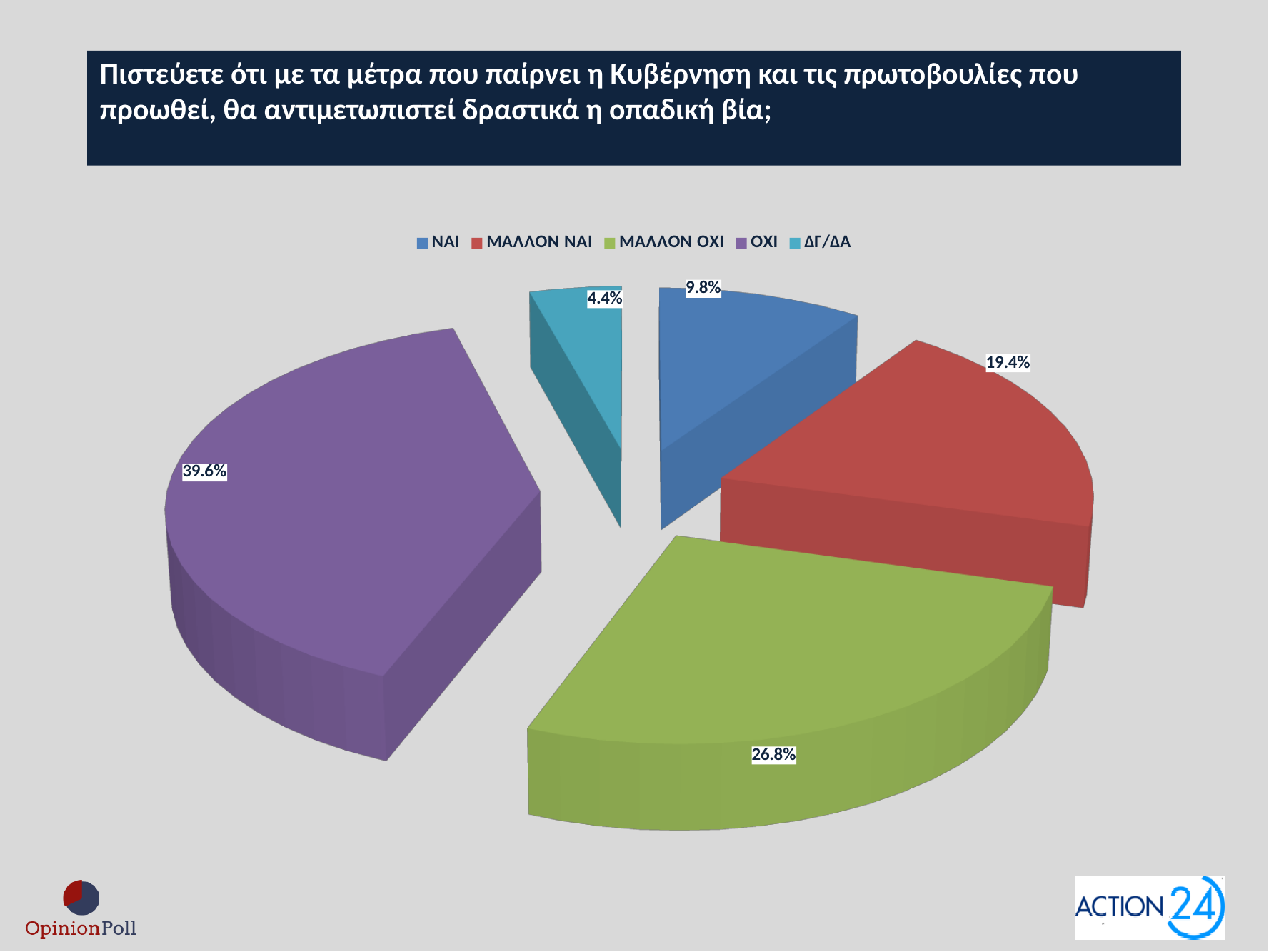
What percentage is shown for ΜΑΛΛΟΝ ΝΑΙ? 19.4% Which is larger, the share for ΜΑΛΛΟΝ ΝΑΙ or the share for ΝΑΙ? ΜΑΛΛΟΝ ΝΑΙ What percentage is shown for ΟΧΙ? 39.6% What percentage is shown for ΜΑΛΛΟΝ ΟΧΙ? 26.8% What is the difference in percentage points between ΟΧΙ and ΜΑΛΛΟΝ ΟΧΙ? 12.8 What colour is the slice for ΜΑΛΛΟΝ ΟΧΙ? green What percentage is shown for ΝΑΙ? 9.8% How many slices does the pie chart have? 5 What kind of chart is shown on the slide? pie chart Which category has the smallest share of the pie? ΔΓ/ΔΑ What percentage is shown for ΔΓ/ΔΑ? 4.4% Which category has the largest share of the pie? ΟΧΙ